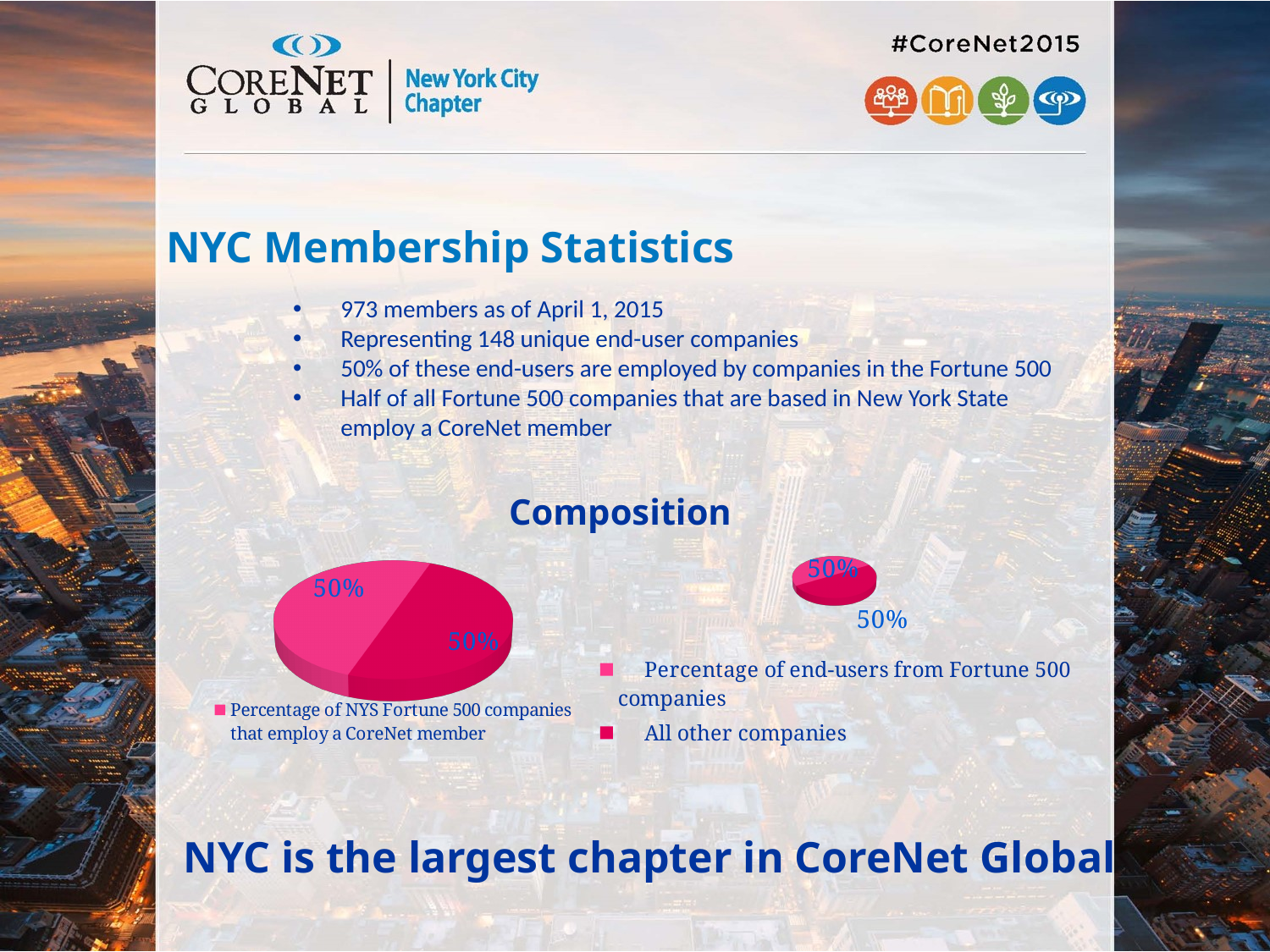
In the left pie chart, what percentage is shown on the upper-left slice? 50% How many entries does the legend of the right pie chart list? 2 In the left pie chart, how many slices are shown? 2 In the right pie chart, what share is labelled for "All other companies"? 50% In the right pie chart, how many slices are shown? 2 What is the legend entry shown for the left pie chart? Percentage of NYS Fortune 500 companies that employ a CoreNet member What heading appears above the two pie charts? Composition In the right pie chart, what share is labelled for "Percentage of end-users from Fortune 500 companies"? 50% In the left pie chart, what percentage is shown on the larger-looking lower-right slice? 50% How many entries does the legend of the left pie chart list? 1 What kind of chart is the right chart under "Composition"? pie chart What kind of chart is the left chart under "Composition"? pie chart